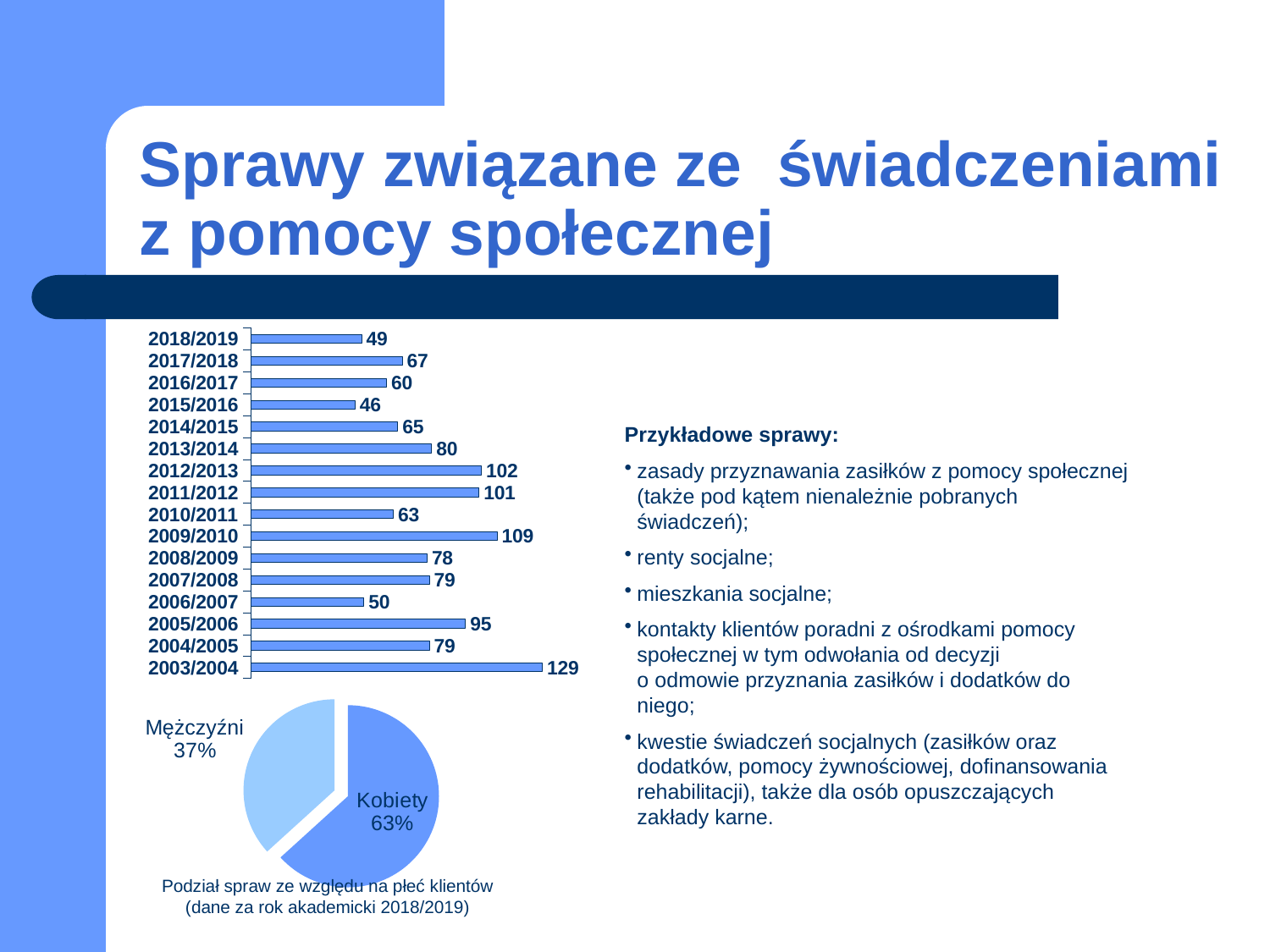
In the bar chart, what is the value for 2003/2004? 129 In the bar chart, what is the difference between the values for 2003/2004 and 2018/2019? 80 How many years are shown in the bar chart? 16 In the pie chart, what share is labelled Mężczyźni? 37% In the pie chart, what share is labelled Kobiety? 63% What kind of chart is the top-left chart on the slide? bar chart In the bar chart, what is the value for 2018/2019? 49 In the bar chart, what is the value for 2009/2010? 109 In the bar chart, which is larger: the value for 2005/2006 or the value for 2013/2014? 2005/2006 In the bar chart, what is the difference between the values for 2012/2013 and 2011/2012? 1 In the bar chart, which year has the lowest value? 2015/2016 In the bar chart, which year has the highest value? 2003/2004